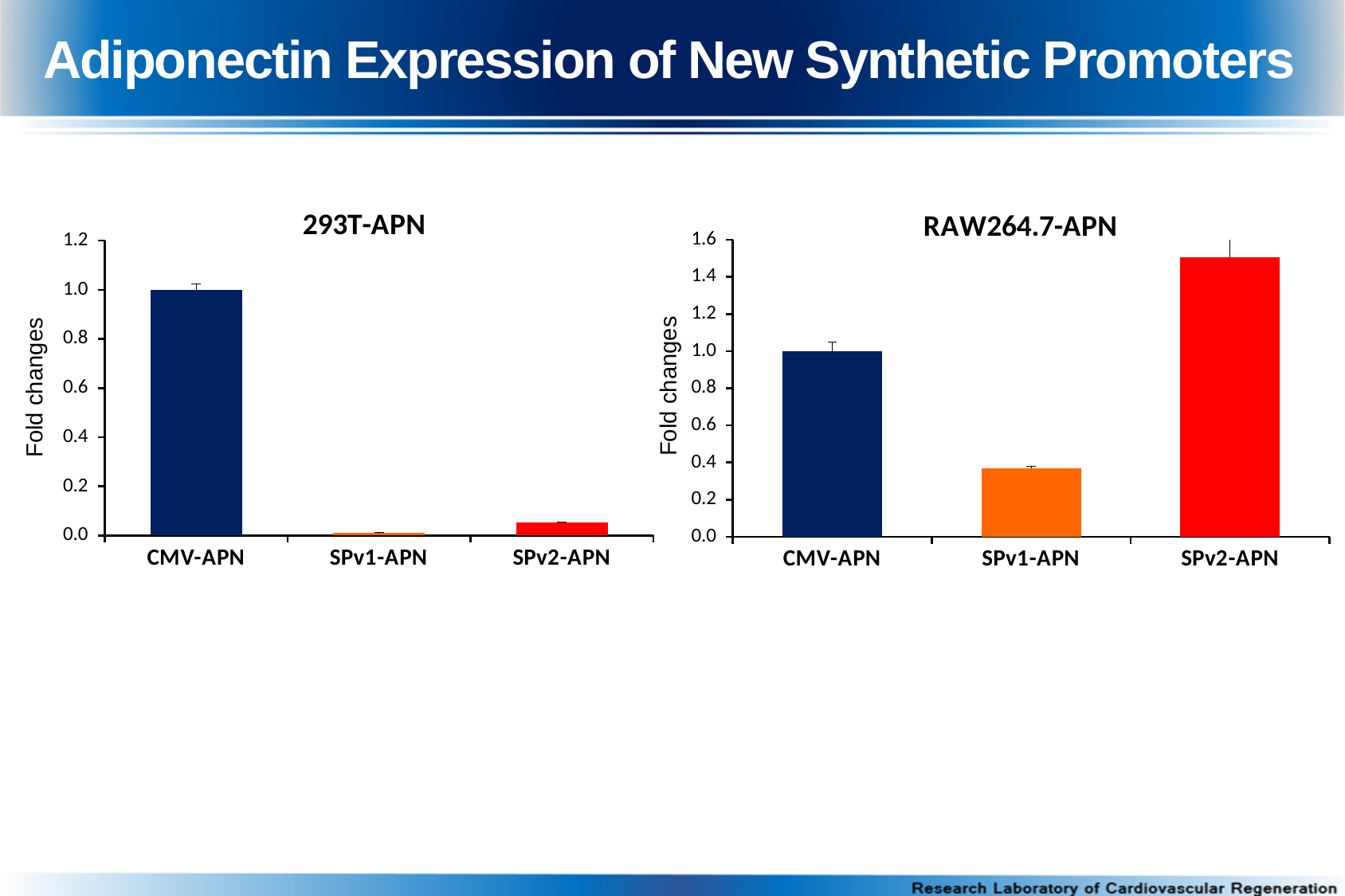
In the RAW264.7-APN chart, is the value for SPv2-APN greater or less than 1.4? greater What type of chart is the RAW264.7-APN chart? bar chart In the 293T-APN chart, which category has the highest fold change? CMV-APN In the RAW264.7-APN chart, which category has the highest fold change? SPv2-APN In the RAW264.7-APN chart, which is larger, the value for SPv2-APN or the value for CMV-APN? SPv2-APN In the RAW264.7-APN chart, what is the fold change for CMV-APN? 1.0 In the 293T-APN chart, what is the fold change for CMV-APN? 1.0 In the 293T-APN chart, which category has the lowest fold change? SPv1-APN In the 293T-APN chart, is the value for SPv2-APN greater or less than 0.2? less How many categories are shown on the x axis of the 293T-APN chart? 3 In the RAW264.7-APN chart, which category has the lowest fold change? SPv1-APN